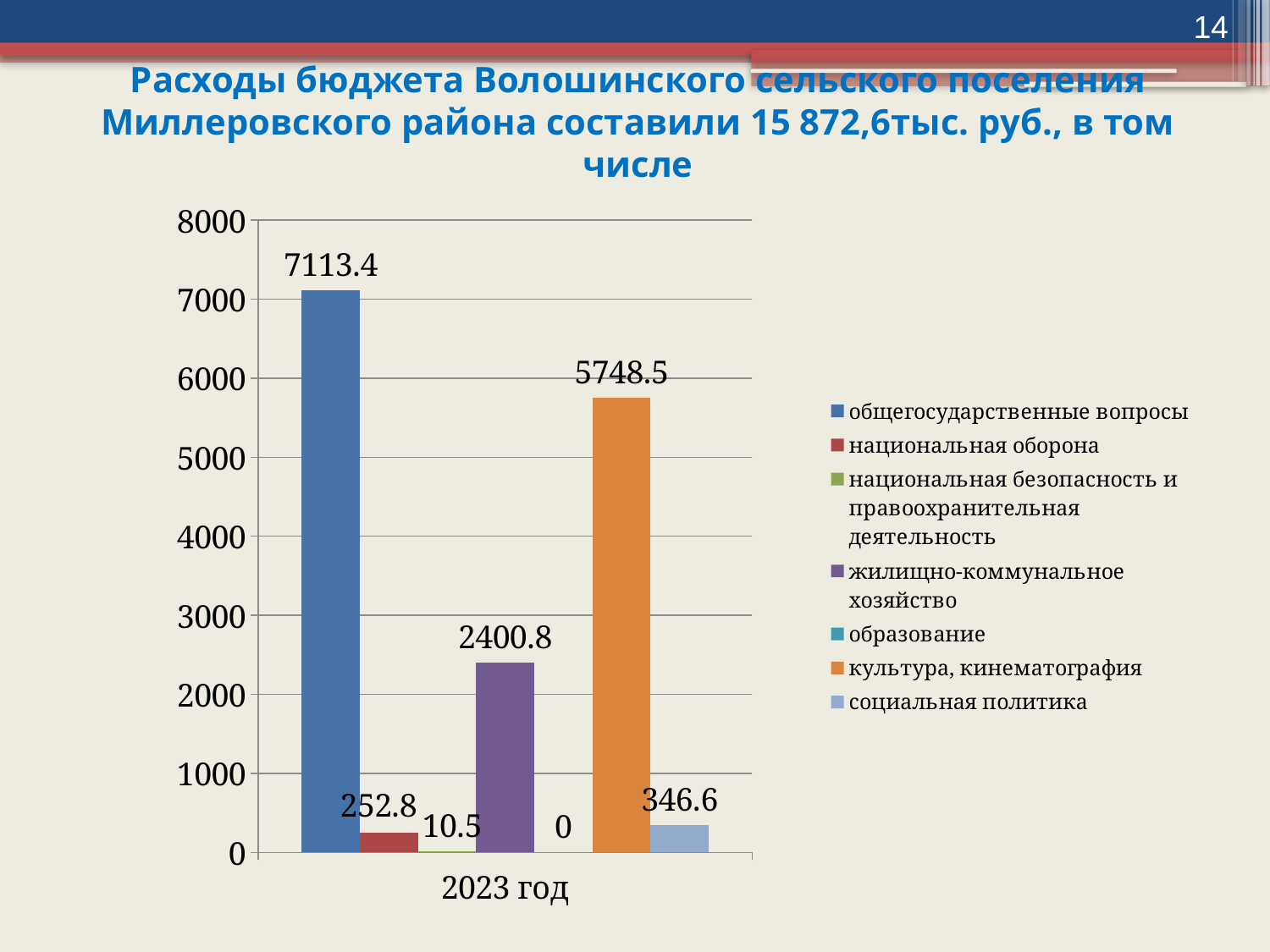
Which series has the highest value in 2023 год? общегосударственные вопросы What is the value for жилищно-коммунальное хозяйство in 2023 год? 2400.8 Which is larger in 2023 год: национальная оборона or социальная политика? социальная политика What is the category label on the x axis of the chart? 2023 год What is the value for культура, кинематография in 2023 год? 5748.5 What kind of chart is shown on the slide? bar chart What is the value for общегосударственные вопросы in 2023 год? 7113.4 What is the value for социальная политика in 2023 год? 346.6 What is the difference between общегосударственные вопросы and культура, кинематография in 2023 год? 1364.9 Which series has the lowest value in 2023 год? образование What is the value for образование in 2023 год? 0 How many series does the legend list? 7